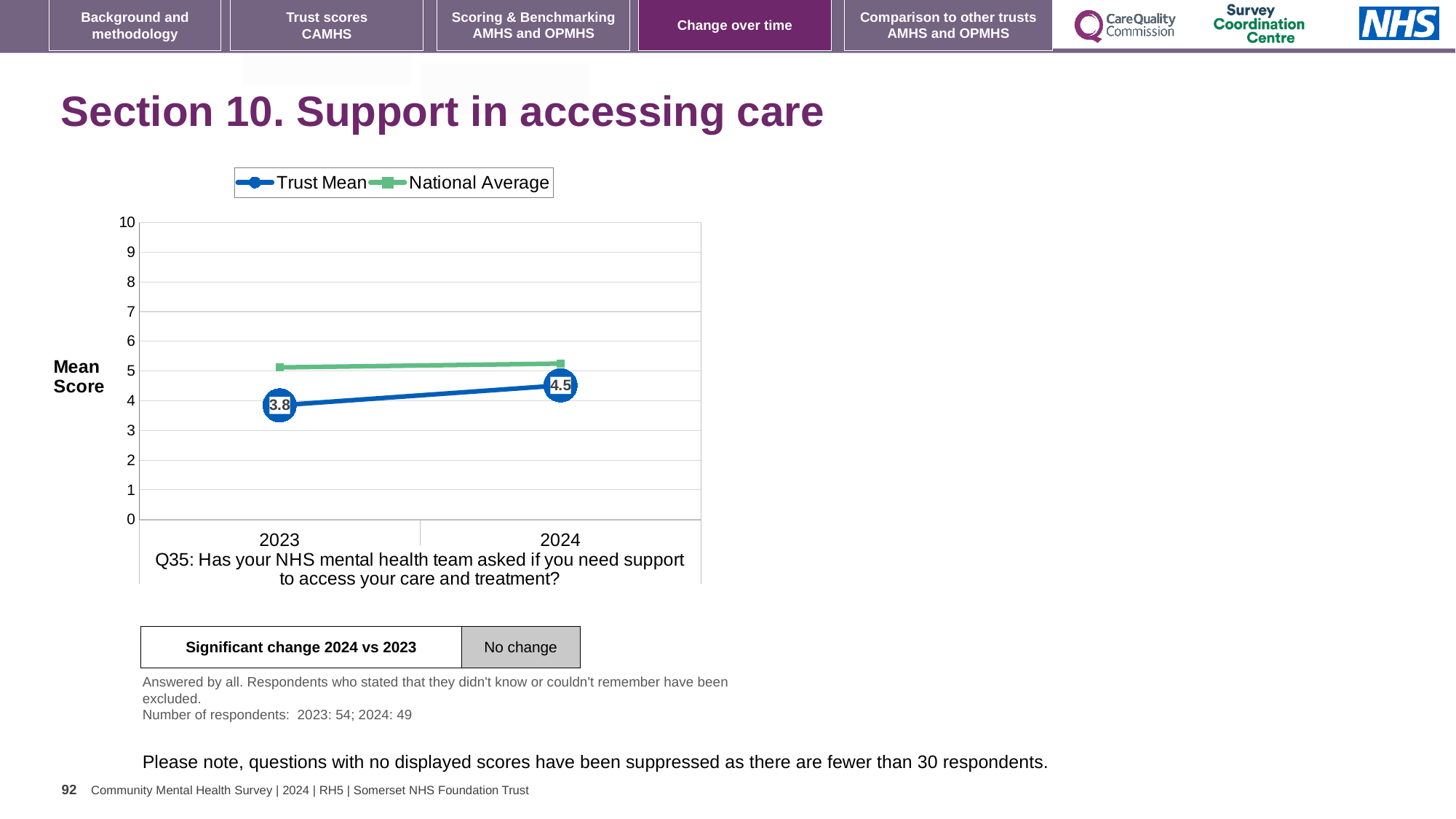
By how much did the Trust Mean change from 2023 to 2024? 0.7 What is the Trust Mean value for 2024? 4.5 How many series does the legend list? 2 Is the National Average value for 2023 greater or less than 6? less In which year is the Trust Mean higher, 2023 or 2024? 2024 What kind of chart is shown on the slide? line chart Is the National Average value for 2024 greater or less than 4? greater How many years are plotted on the x axis? 2 In 2023, which series has the higher value, Trust Mean or National Average? National Average What is the label on the y axis of the chart? Mean Score Does the Trust Mean line rise or fall from 2023 to 2024? rise What is the Trust Mean value for 2023? 3.8